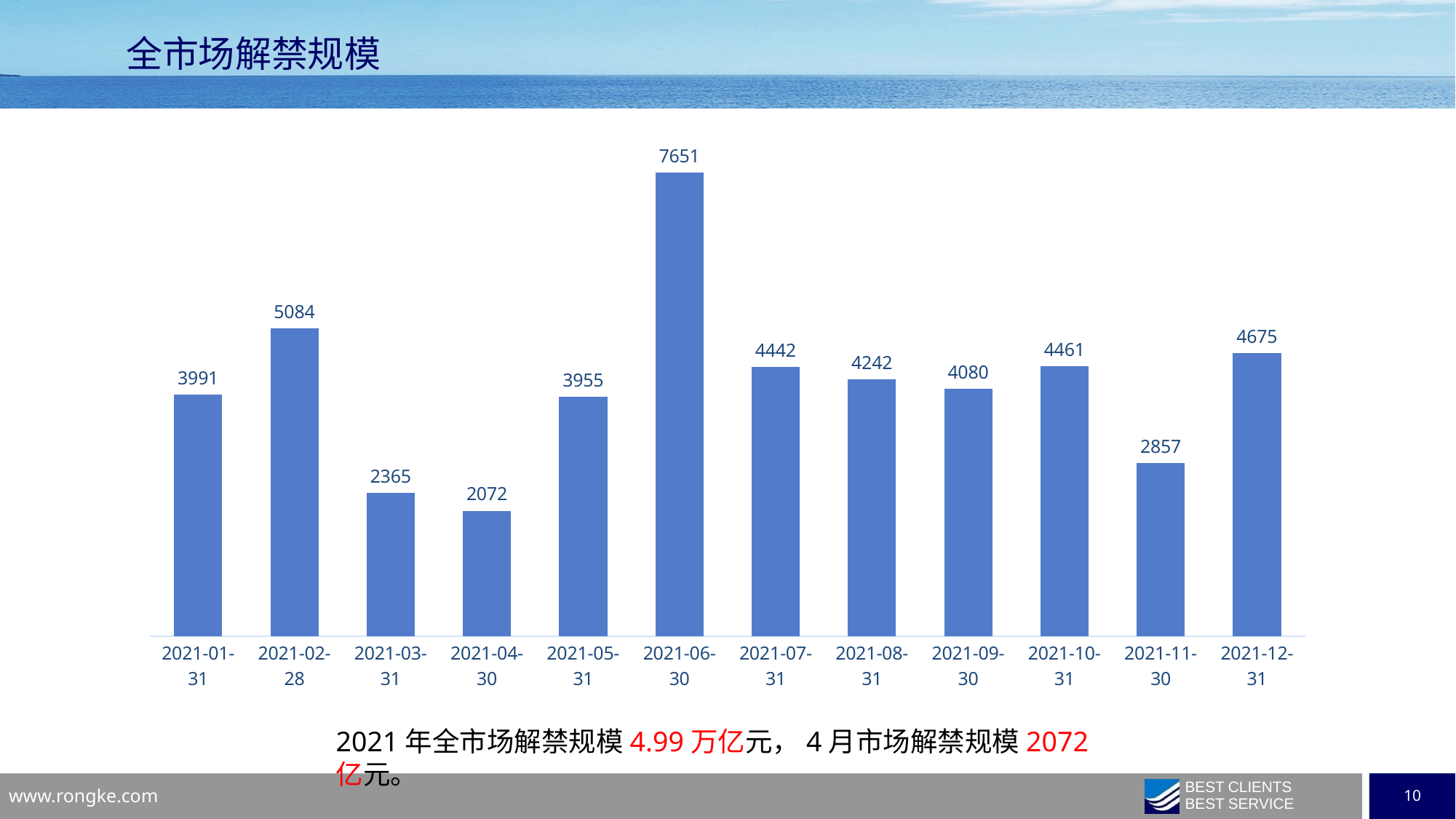
Which is larger, the value for 2021-01-31 or the value for 2021-05-31? 2021-01-31 What kind of chart is shown on the slide? Bar chart What is the difference between the values for 2021-06-30 and 2021-02-28? 2567 What is the value for 2021-04-30? 2072 Do the values rise or fall from 2021-06-30 to 2021-09-30? Fall What is the difference between the values for 2021-12-31 and 2021-11-30? 1818 Which is larger, the value for 2021-03-31 or the value for 2021-09-30? 2021-09-30 What is the value for 2021-06-30? 7651 What is the value for 2021-11-30? 2857 How many months are shown on the x axis? 12 Which month has the lowest value? 2021-04-30 Which month has the highest value? 2021-06-30